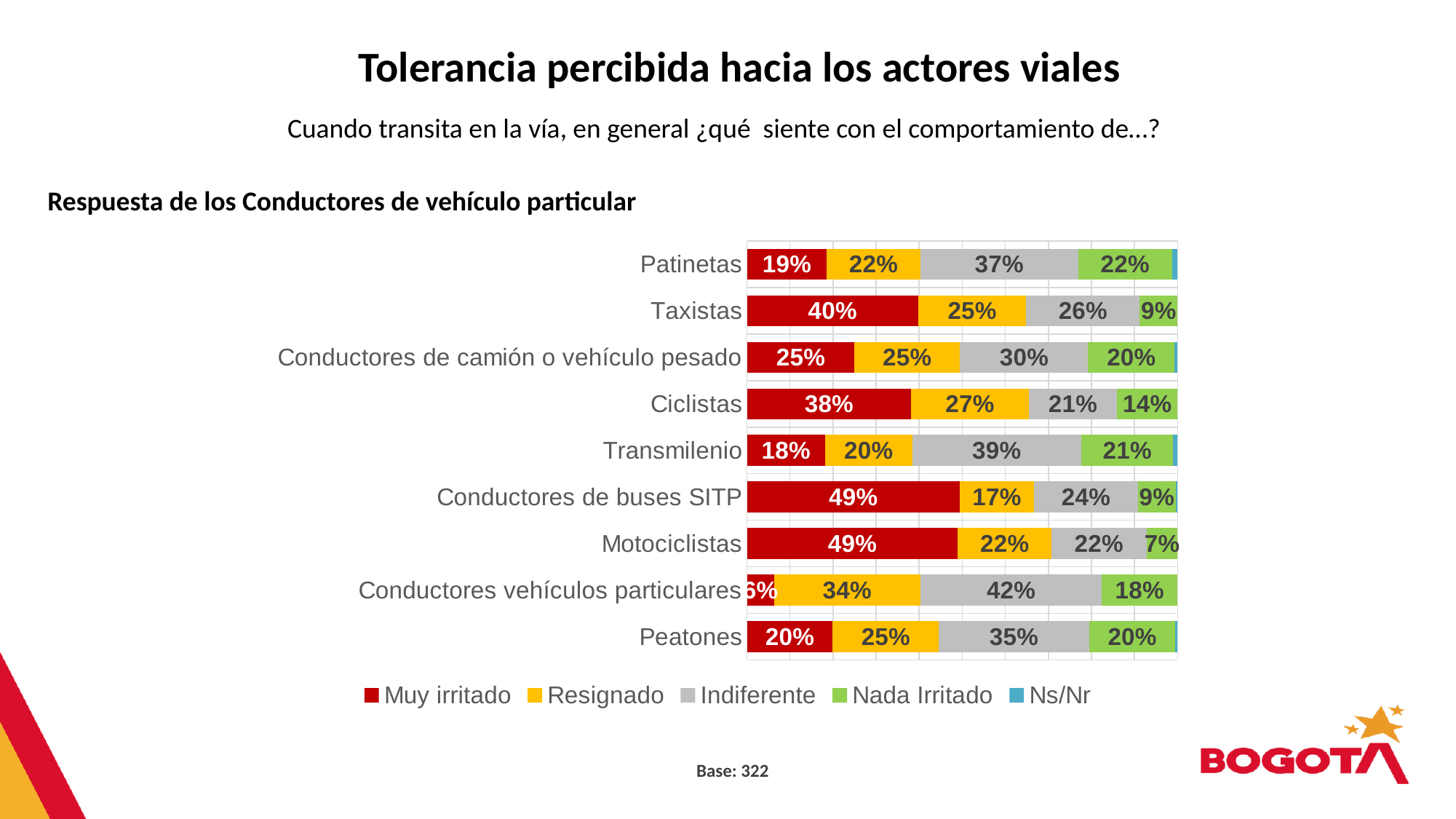
Which category has the highest 'Indiferente' value? Conductores vehículos particulares Which has a larger 'Muy irritado' value, Ciclistas or Transmilenio? Ciclistas What is the 'Nada Irritado' value for Ciclistas? 14% How many series does the legend list? 5 What type of chart is shown on the slide? Stacked bar chart Which category has the lowest 'Muy irritado' value? Conductores vehículos particulares What is the difference between the 'Muy irritado' value for Taxistas and for Patinetas? 21 percentage points How many road-actor categories are plotted in the chart? 9 What is the 'Resignado' value for Conductores de buses SITP? 17% What is the 'Indiferente' value for Transmilenio? 39% Which category has the lowest 'Nada Irritado' value? Motociclistas What is the 'Muy irritado' value for Taxistas? 40%